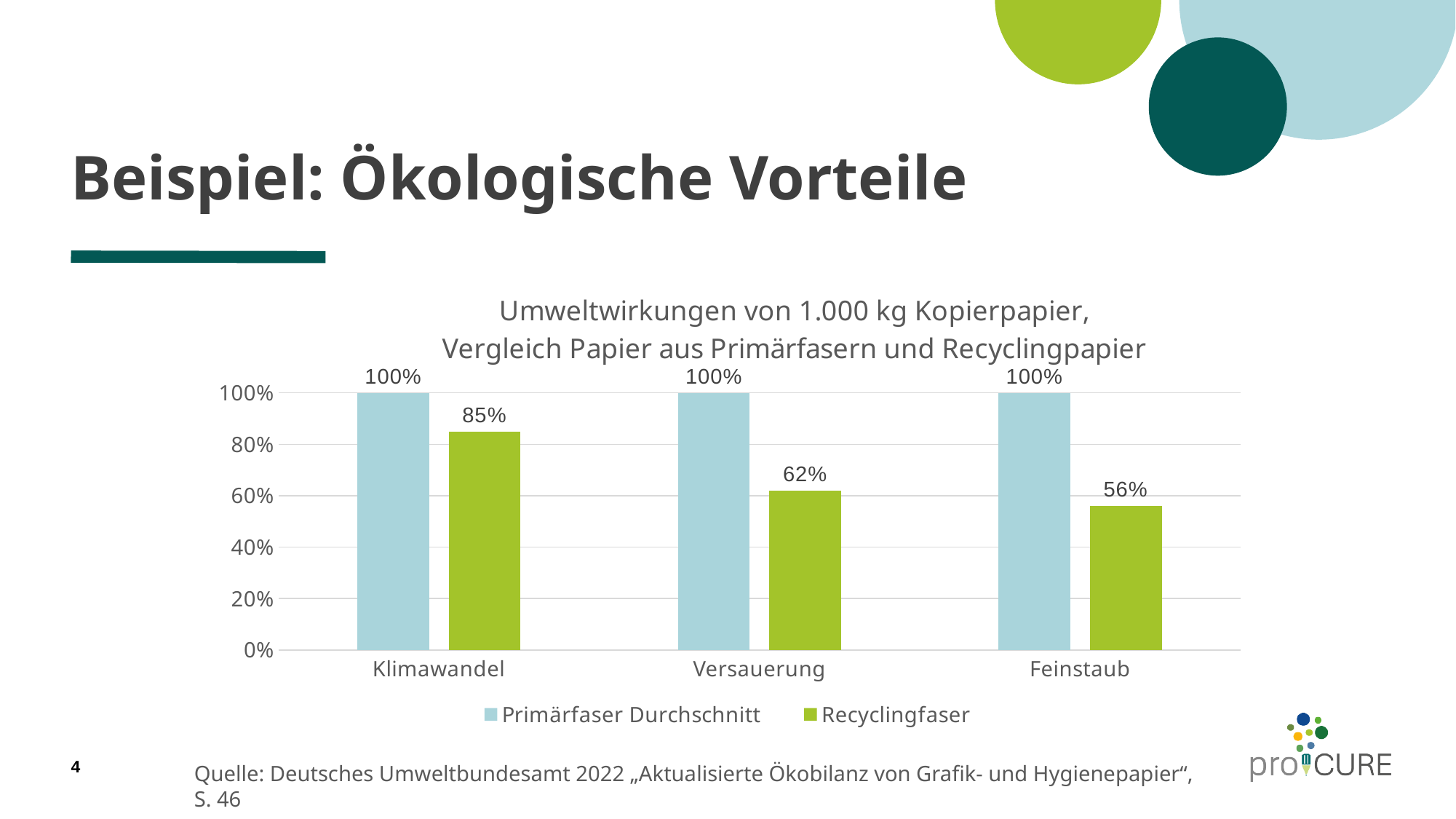
In which category is the Recyclingfaser value lowest? Feinstaub Which is larger: the Recyclingfaser value for Klimawandel or for Feinstaub? Klimawandel What kind of chart is shown on the slide? Bar chart In which category is the Recyclingfaser value highest? Klimawandel How many categories are shown on the x axis? 3 Which series is shown in green in the chart? Recyclingfaser What is the value for Recyclingfaser in the Feinstaub category? 56% How many series does the legend list? 2 What is the difference between Primärfaser Durchschnitt and Recyclingfaser in the Versauerung category? 38% What is the value for Primärfaser Durchschnitt in the Feinstaub category? 100% What is the value for Recyclingfaser in the Versauerung category? 62% What is the value for Recyclingfaser in the Klimawandel category? 85%